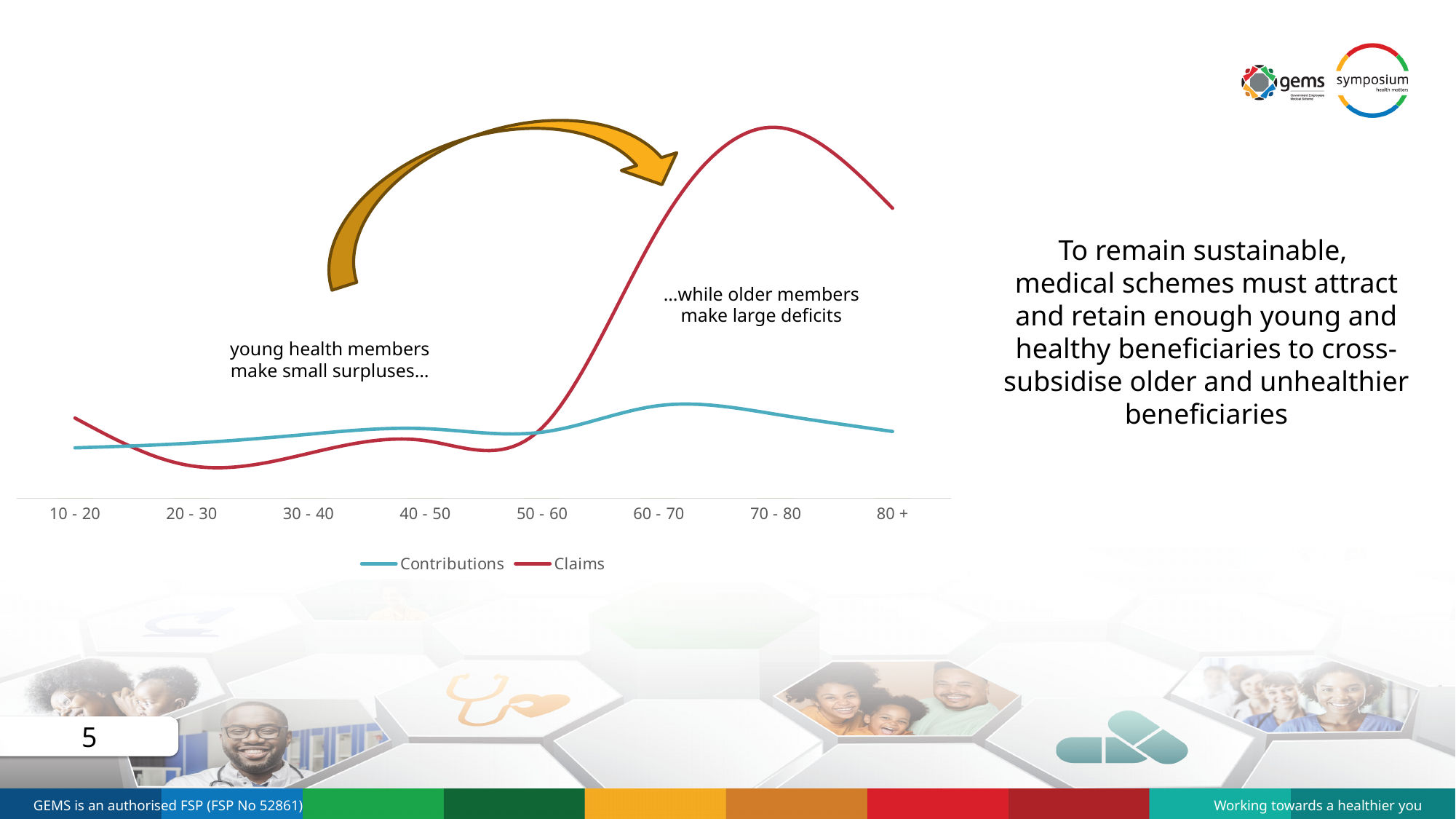
At the 70 - 80 age category, which series is higher, Contributions or Claims? Claims In which age category does the Contributions line reach its highest point? 60 - 70 What kind of chart is shown on the slide? line chart How many series does the chart legend list? 2 Which series is drawn in red on the chart? Claims How many age categories are shown on the x axis of the chart? 8 What is the first age category on the x axis of the chart? 10 - 20 Does the Claims line rise or fall from the 50 - 60 category to the 70 - 80 category? rise In which age category does the Claims line reach its highest point? 70 - 80 In which age category does the Claims line reach its lowest point? 20 - 30 At the 20 - 30 age category, which series is higher, Contributions or Claims? Contributions Does the Claims line rise or fall from the 70 - 80 category to the 80 + category? fall